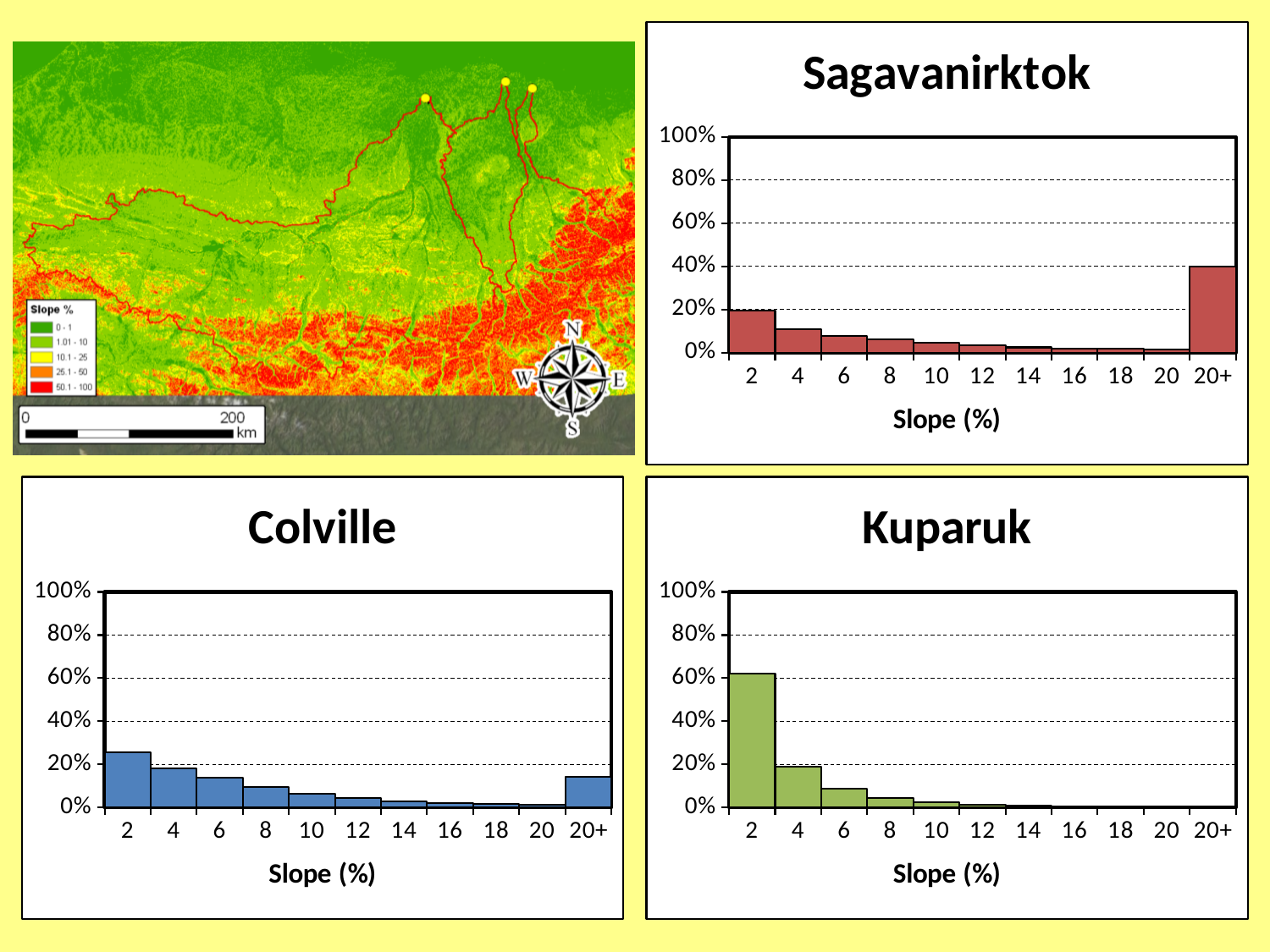
In the Sagavanirktok chart, which is larger, the value for the 2 category or the 20+ category? 20+ In the Sagavanirktok chart, is the value for the 20+ slope category greater or less than 20%? greater What is the x-axis title of the Sagavanirktok chart? Slope (%) How many slope categories are shown on the x axis of the Kuparuk chart? 11 In the Colville chart, which is larger, the value for the 2 category or the 20+ category? 2 In the Colville chart, is the value for the 2 slope category greater or less than 20%? greater In the Kuparuk chart, is the value for the 2 slope category greater or less than 40%? greater What kind of chart is the Colville chart? bar chart In the Kuparuk chart, which slope category has the highest value? 2 In the Colville chart, which slope category has the highest value? 2 In the Sagavanirktok chart, which slope category has the highest value? 20+